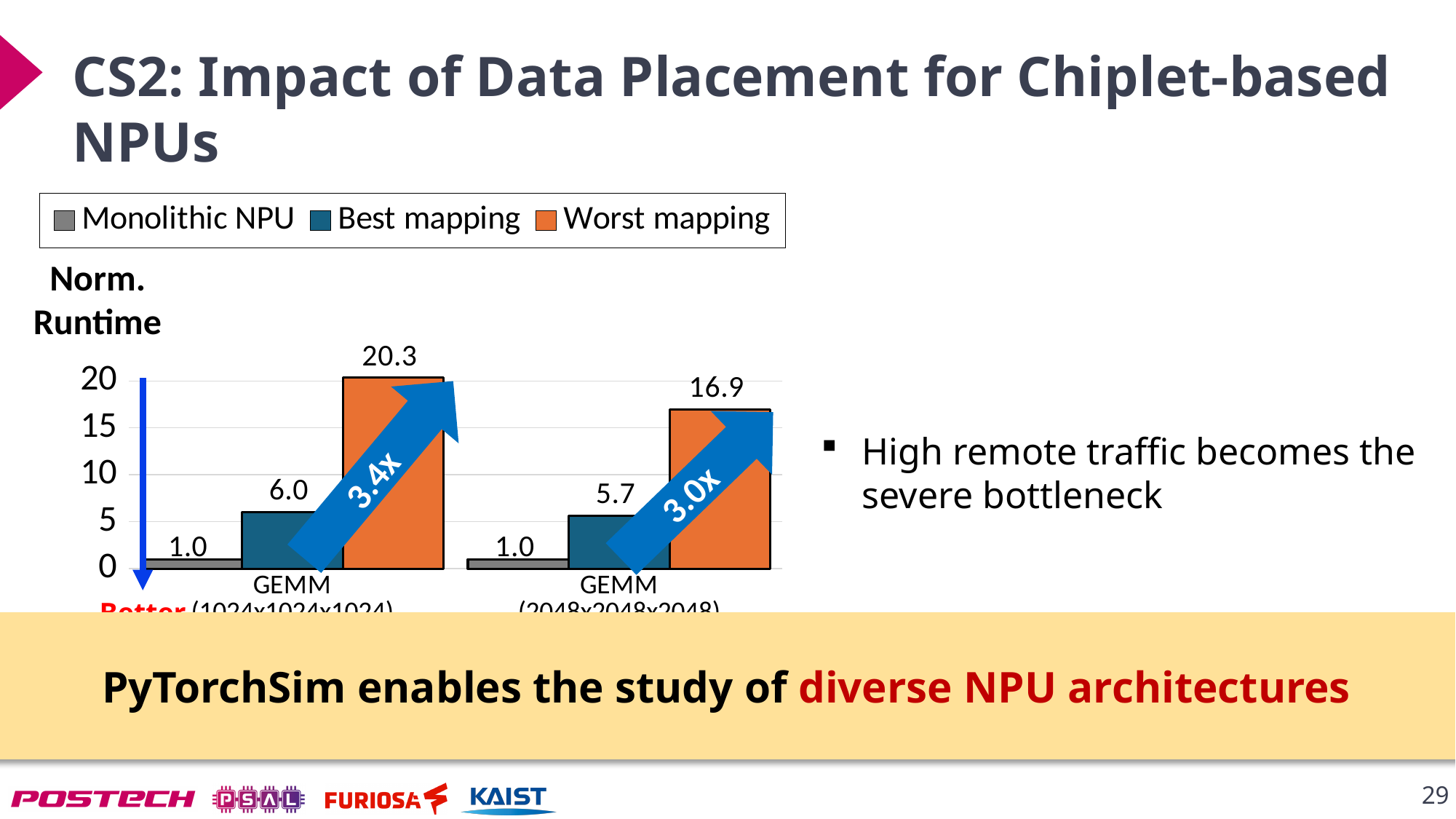
What is the difference between the Worst mapping and Best mapping normalized runtimes for GEMM (1024x1024x1024)? 14.3 What kind of chart is shown on the slide? Bar chart What is the normalized runtime for Monolithic NPU on GEMM (1024x1024x1024)? 1.0 What colour represents Worst mapping in the legend? Orange What is the normalized runtime for Best mapping on GEMM (2048x2048x2048)? 5.7 Which series has the lowest normalized runtime for GEMM (2048x2048x2048)? Monolithic NPU Which is larger: the Worst mapping value for GEMM (1024x1024x1024) or for GEMM (2048x2048x2048)? GEMM (1024x1024x1024) How many categories are shown on the x axis? 2 What is the normalized runtime for Worst mapping on GEMM (2048x2048x2048)? 16.9 How many series does the legend list? 3 Which series has the highest normalized runtime for GEMM (1024x1024x1024)? Worst mapping What is the normalized runtime for Worst mapping on GEMM (1024x1024x1024)? 20.3